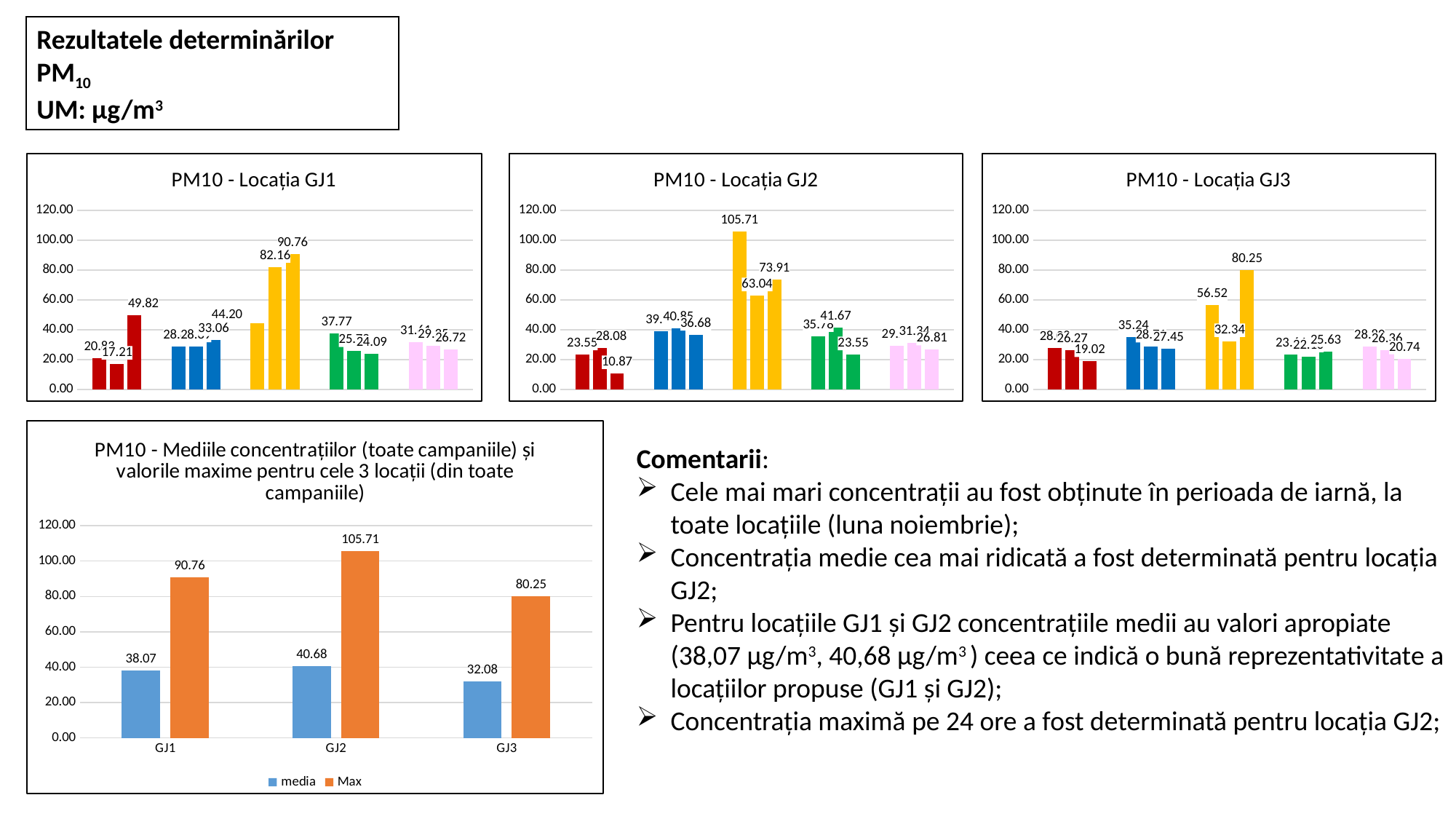
In the chart 'PM10 - Locația GJ2', what is the highest value shown? 105.71 In the bottom-left chart (PM10 - Mediile concentrațiilor), what is the difference between the 'Max' and 'media' values for GJ2? 65.03 In the bottom-left chart (PM10 - Mediile concentrațiilor), which is larger: the 'media' value for GJ1 or for GJ2? GJ2 In the bottom-left chart (PM10 - Mediile concentrațiilor), how many series does the legend list? 2 In the bottom-left chart (PM10 - Mediile concentrațiilor), which location has the highest 'Max' value? GJ2 In the chart 'PM10 - Locația GJ2', what is the lowest value shown? 10.87 In the bottom-left chart (PM10 - Mediile concentrațiilor), what is the 'media' value for GJ1? 38.07 In the bottom-left chart (PM10 - Mediile concentrațiilor), what is the 'Max' value for GJ3? 80.25 In the bottom-left chart (PM10 - Mediile concentrațiilor), how many locations are shown on the x axis? 3 What kind of chart is 'PM10 - Locația GJ2'? Bar chart In the chart 'PM10 - Locația GJ1', is the tallest bar greater or less than 80? greater In the bottom-left chart (PM10 - Mediile concentrațiilor), which location has the lowest 'media' value? GJ3